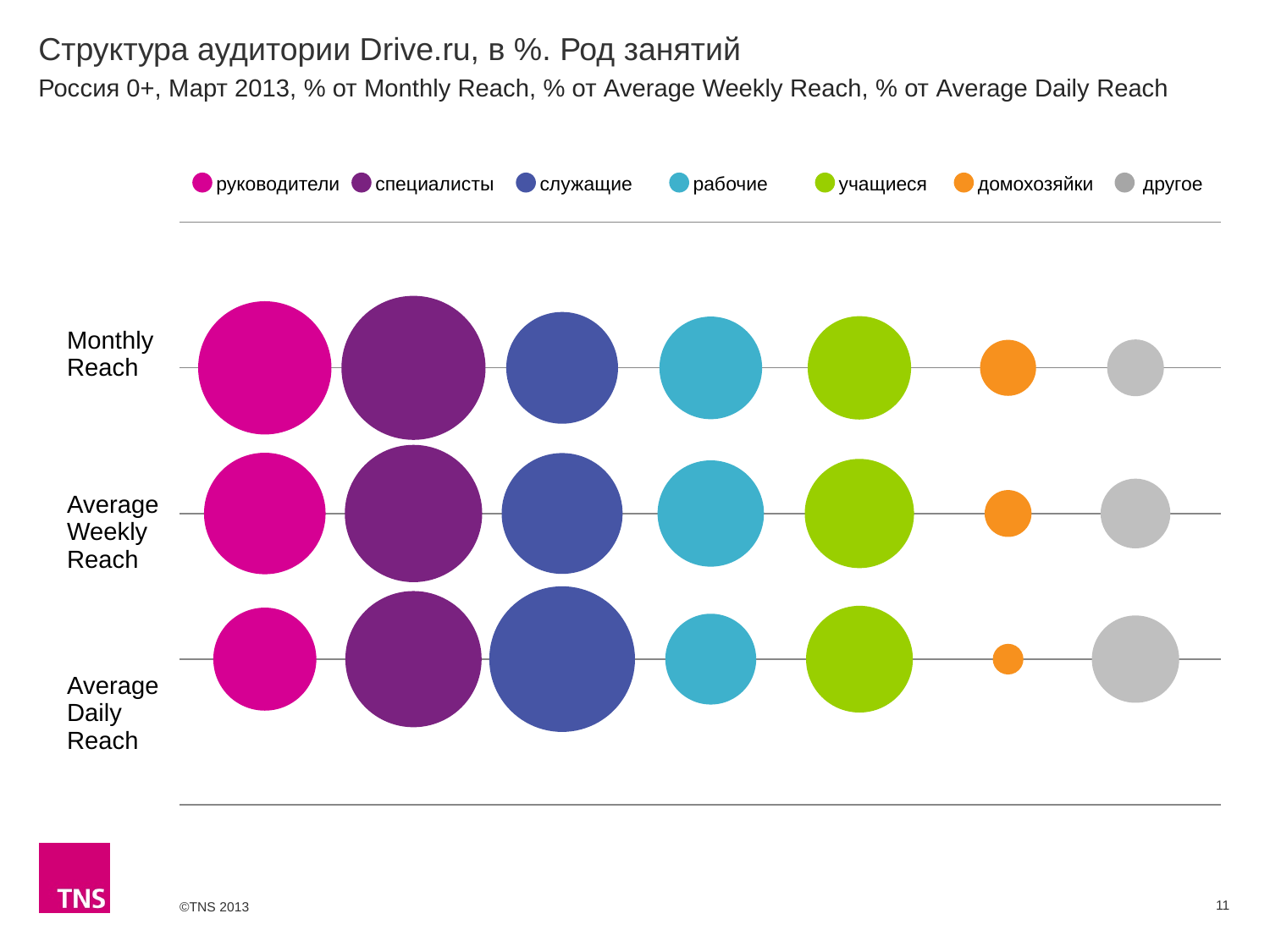
What is the title of the slide? Структура аудитории Drive.ru, в %. Род занятий Does the bubble for домохозяйки get larger or smaller going from Monthly Reach to Average Daily Reach? smaller Which legend entry is shown in orange? домохозяйки Which occupation group has the smallest bubble in the Average Daily Reach row? домохозяйки How many reach rows (categories) are plotted on the chart? 3 Does the bubble for другое get larger or smaller going from Monthly Reach to Average Daily Reach? larger Does the bubble for служащие get larger or smaller going from Monthly Reach to Average Daily Reach? larger In the Monthly Reach row, which bubble is larger: руководители or домохозяйки? руководители In the Average Daily Reach row, which bubble is larger: служащие or рабочие? служащие How many occupation groups does the legend list? 7 What kind of chart is shown on the slide? bubble chart In the Average Daily Reach row, which bubble is larger: другое or домохозяйки? другое